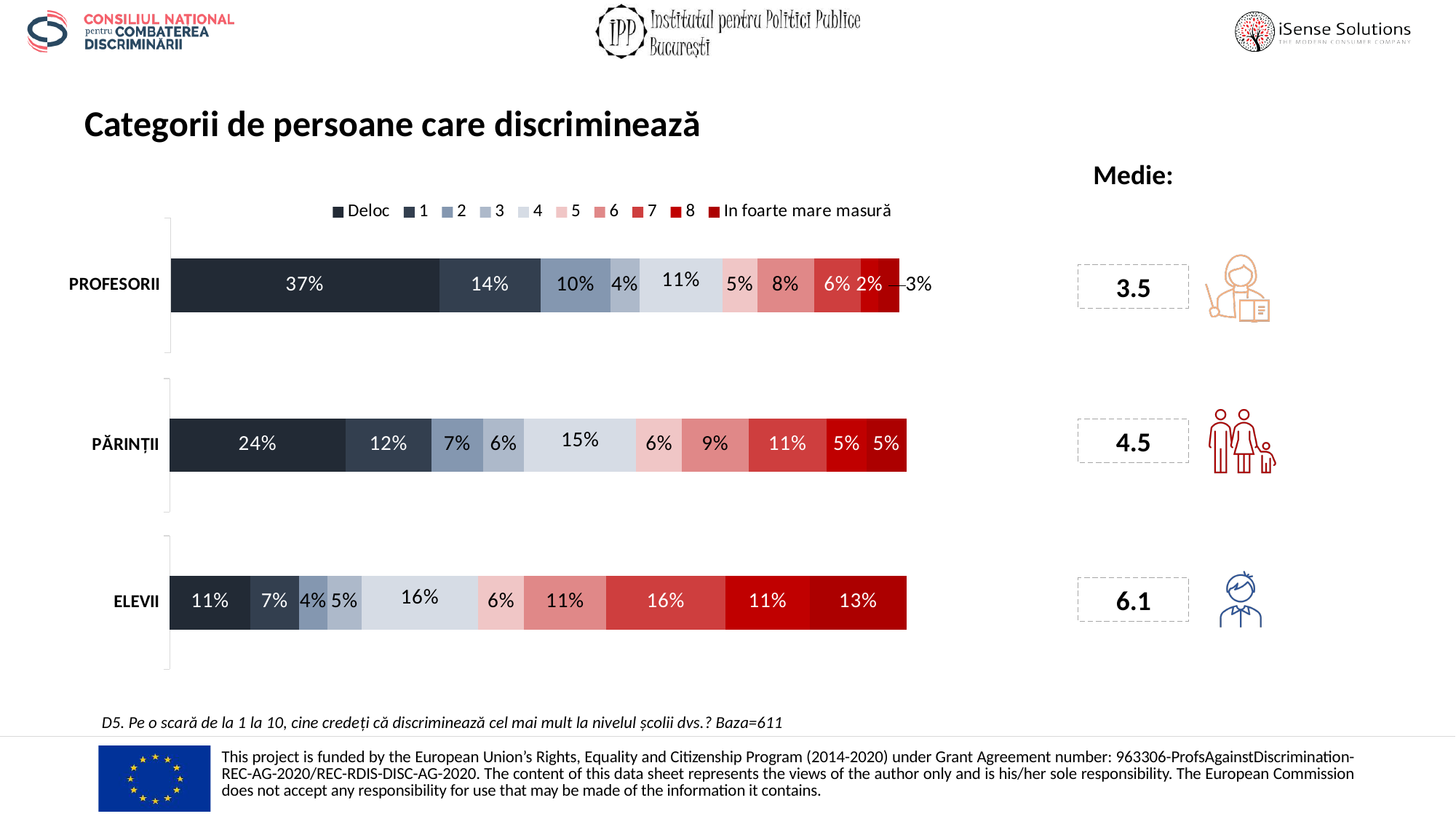
What is the "Medie" value shown next to ELEVII? 6.1 What type of chart is shown on the slide? Stacked bar chart What is the value of the "In foarte mare masură" segment for ELEVII? 13% Which category has the lowest "In foarte mare masură" value? PROFESORII What is the difference between the "Deloc" values for PROFESORII and PĂRINȚII? 13% How many series does the legend list? 10 What is the value of the "4" segment for PĂRINȚII? 15% Which category has the highest "Deloc" value? PROFESORII What is the value of the "7" segment for PROFESORII? 6% How many categories are shown on the chart? 3 What percentage of respondents answered "Deloc" for PROFESORII? 37% Which is larger: the "7" segment for ELEVII or the "7" segment for PĂRINȚII? ELEVII